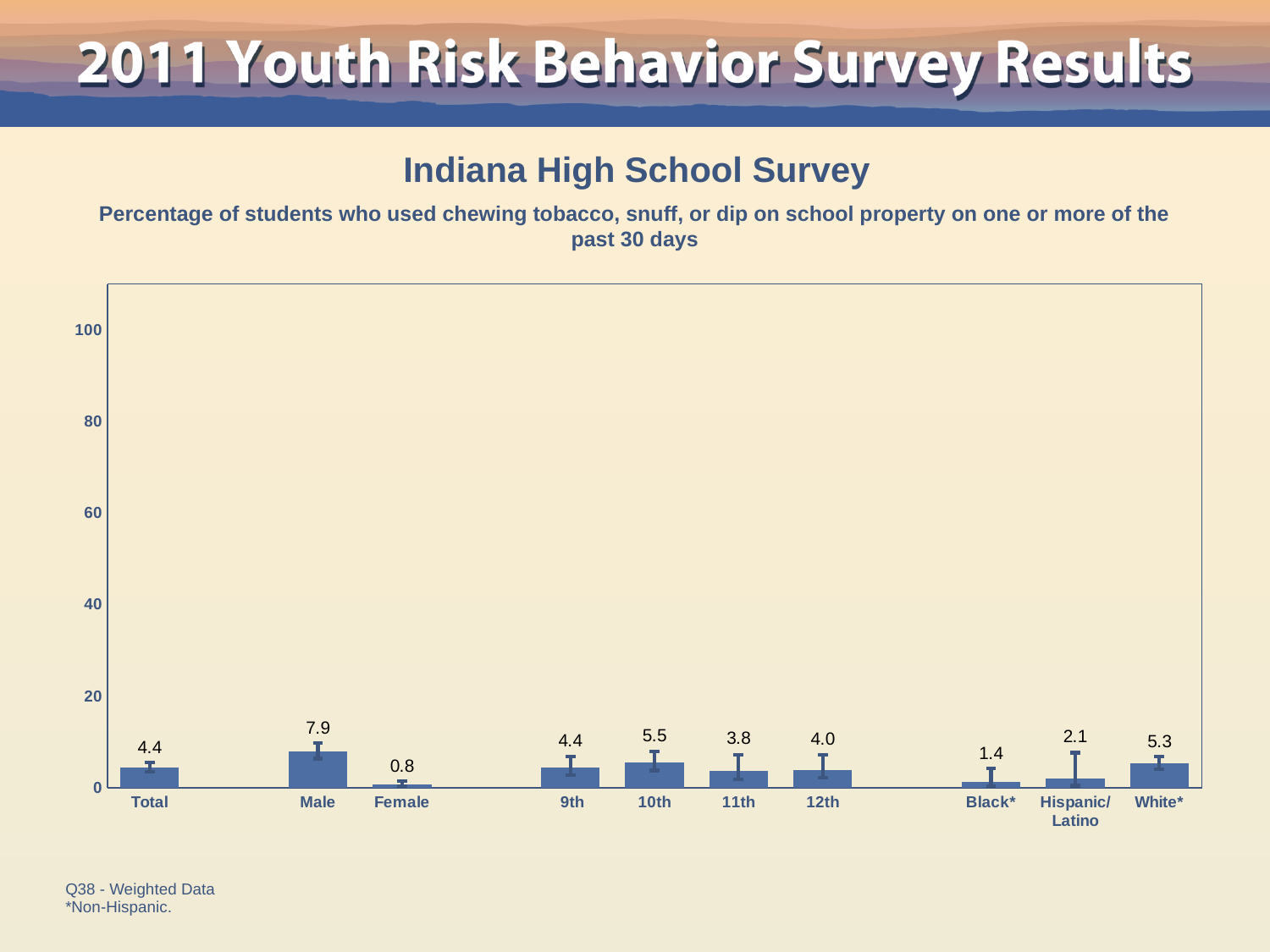
Which is larger, the value for White* or the value for Black*? White* What is the value for Female? 0.8 How many categories are shown on the x axis? 10 What is the value for Hispanic/Latino? 2.1 What is the value for Male? 7.9 What is the value for 10th grade? 5.5 What is the difference between the values for Male and Female? 7.1 What kind of chart is this? bar chart Which category has the highest value? Male What is the title of the chart? Indiana High School Survey Which category has the lowest value? Female Is the value for Male greater or less than 20? less